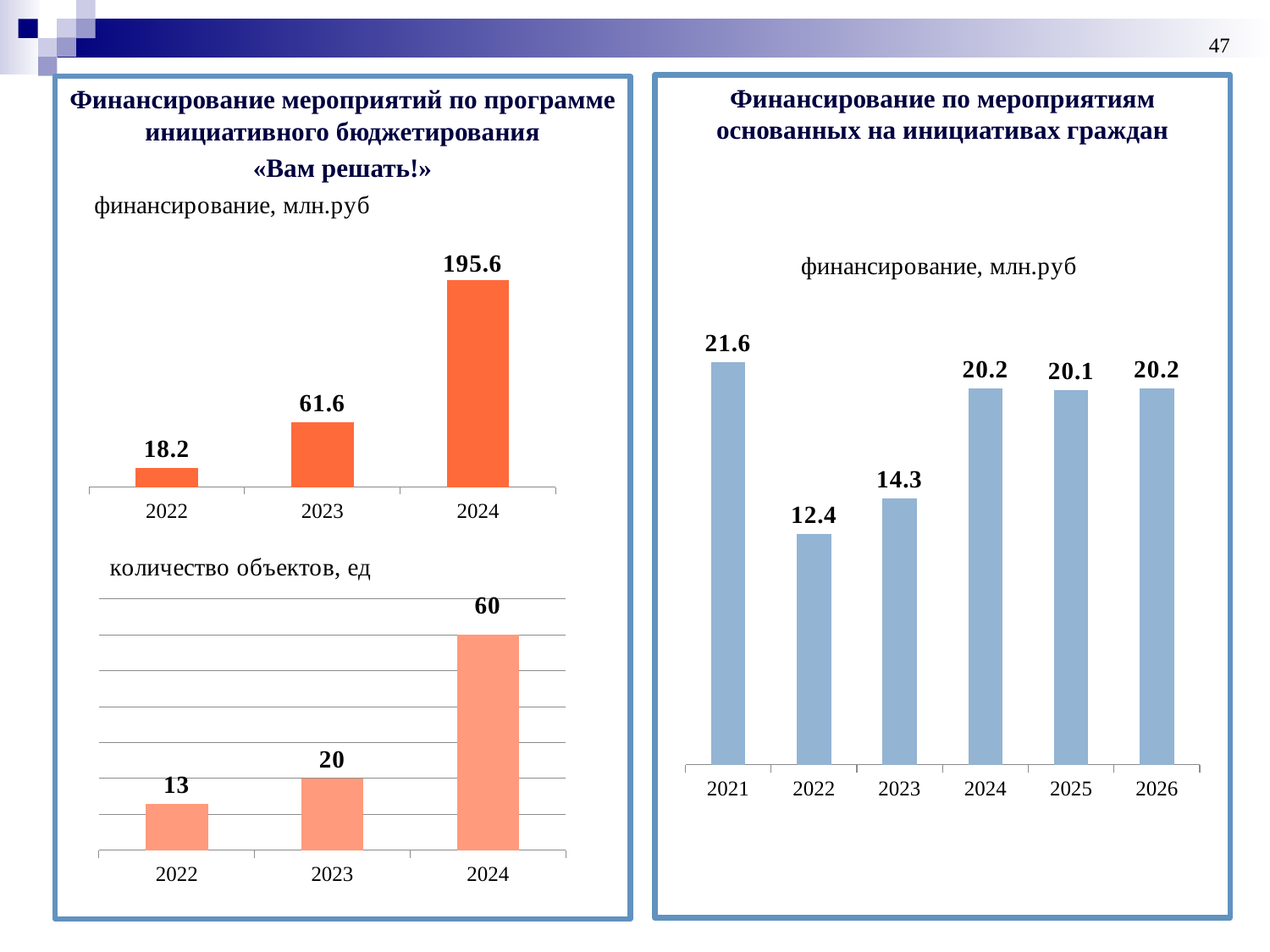
In the bottom-left chart (количество объектов, ед), how many years are shown? 3 In the top-left chart (финансирование, млн.руб under «Вам решать!»), what is the difference between the 2024 and 2023 values? 134 In the top-left chart (финансирование, млн.руб under «Вам решать!»), do the values rise or fall from 2022 to 2024? rise In the right chart (Финансирование по мероприятиям основанных на инициативах граждан), which year has the lowest value? 2022 In the top-left chart (финансирование, млн.руб under «Вам решать!»), what is the value for 2024? 195.6 In the right chart (Финансирование по мероприятиям основанных на инициативах граждан), what is the value for 2021? 21.6 In the bottom-left chart (количество объектов, ед), which year has the highest value? 2024 In the bottom-left chart (количество объектов, ед), what is the difference between the 2024 and 2022 values? 47 In the top-left chart (финансирование, млн.руб under «Вам решать!»), what is the value for 2022? 18.2 In the right chart (Финансирование по мероприятиям основанных на инициативах граждан), how many years are shown? 6 In the bottom-left chart (количество объектов, ед), what is the value for 2023? 20 What kind of chart is the right chart (Финансирование по мероприятиям основанных на инициативах граждан)? bar chart